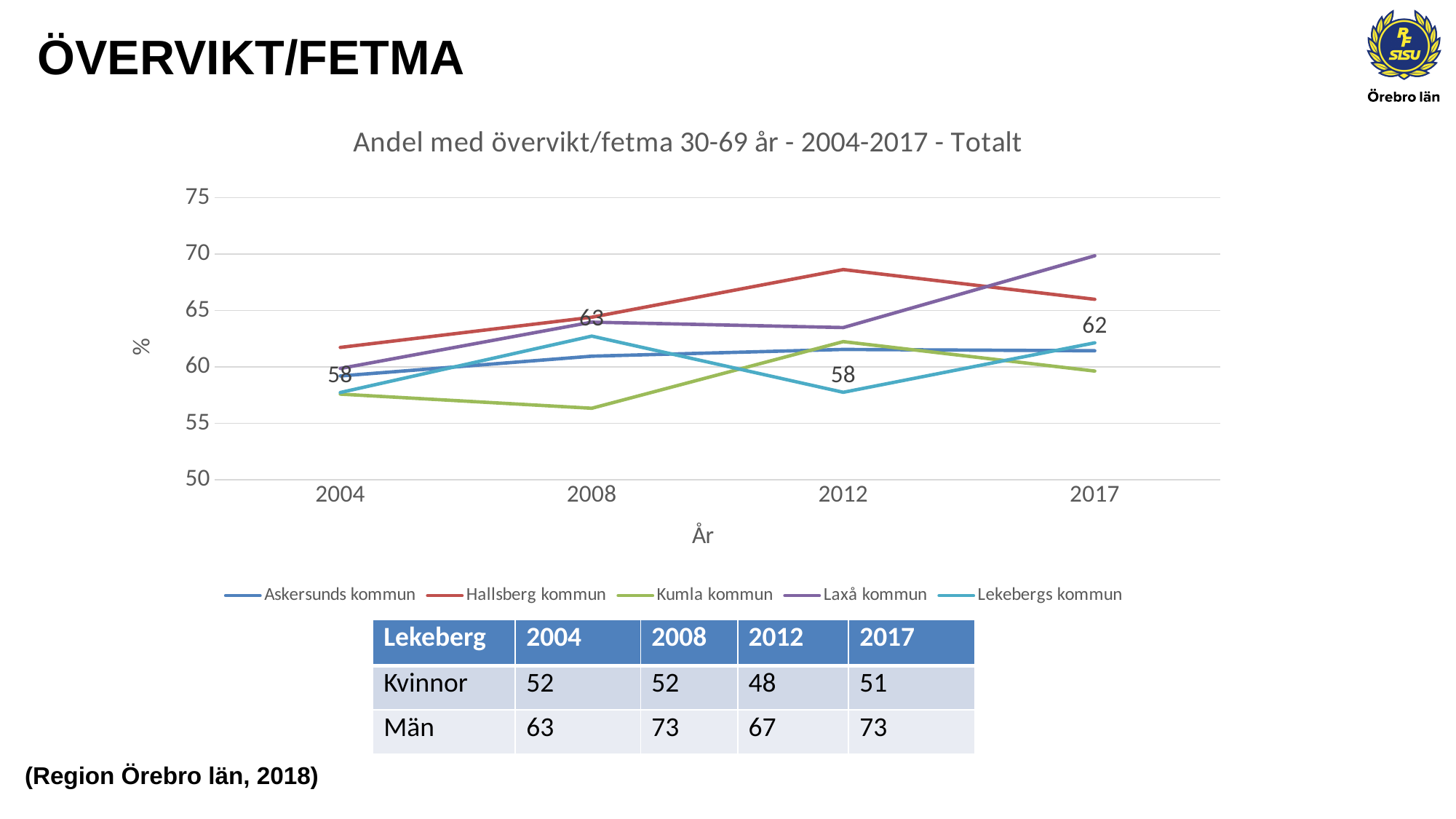
What kind of chart is shown on the slide? line chart By how much did the value for Lekebergs kommun increase from 2004 to 2008? 5 What is the value for Lekebergs kommun in 2008? 63 Is the value for Hallsberg kommun in 2012 greater or less than 65? greater How many series does the chart legend list? 5 How many years are plotted along the x axis of the chart? 4 What is the value for Lekebergs kommun in 2012? 58 Does the value for Laxå kommun rise or fall between 2012 and 2017? rise Which municipality has the highest value in 2017? Laxå kommun Which municipality has the lowest value in 2008? Kumla kommun What is the value for Lekebergs kommun in 2017? 62 Which is higher in 2004, Hallsberg kommun or Askersunds kommun? Hallsberg kommun